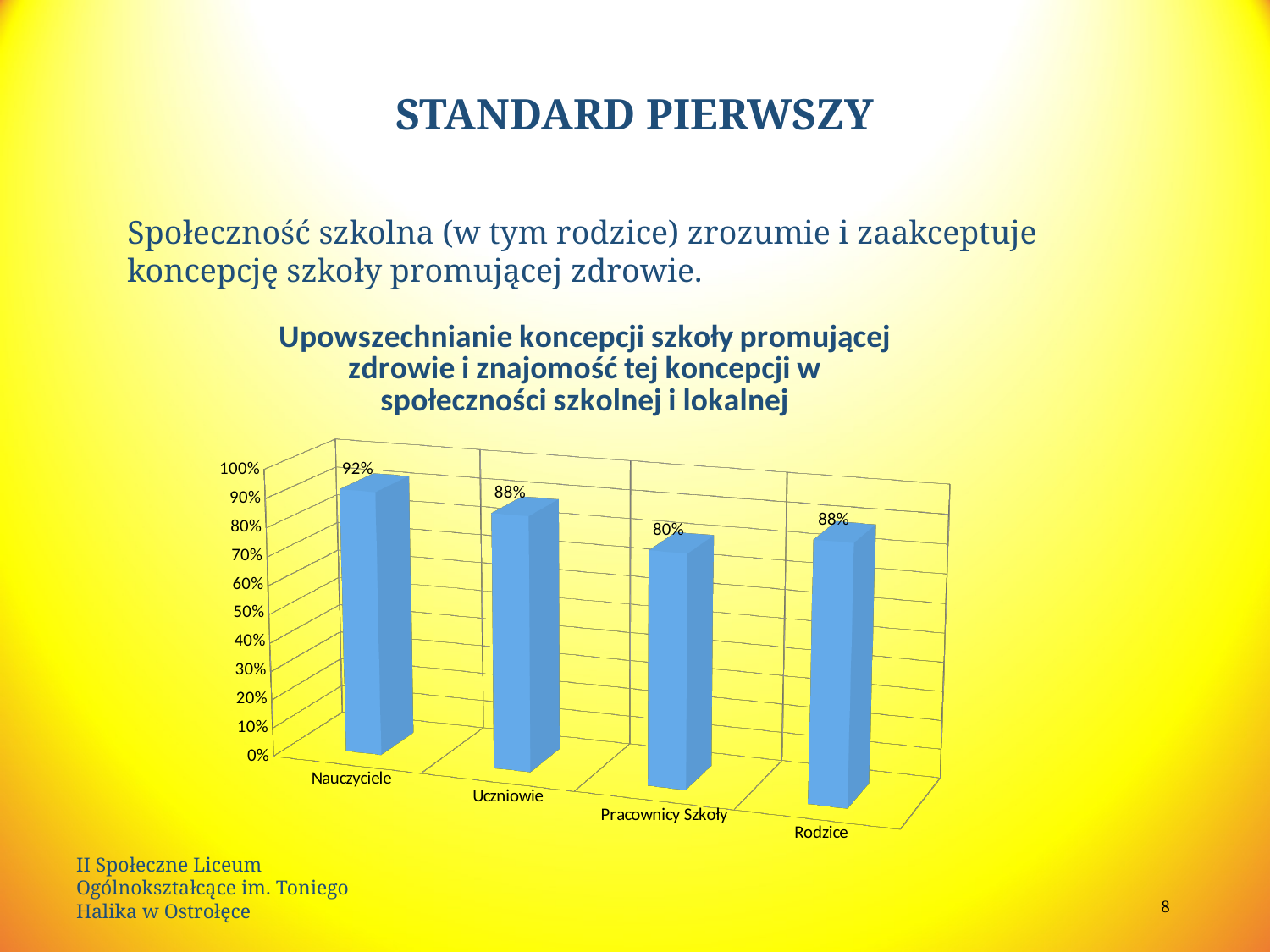
How many categories are shown on the chart? 4 What is the value for Rodzice? 88% Which category has the highest value? Nauczyciele What is the difference between the values for Uczniowie and Pracownicy Szkoły? 8% Is the value for Pracownicy Szkoły greater or less than 90%? less What is the value for Nauczyciele? 92% What is the difference between the values for Nauczyciele and Pracownicy Szkoły? 12% What is the title of the chart? Upowszechnianie koncepcji szkoły promującej zdrowie i znajomość tej koncepcji w społeczności szkolnej i lokalnej What kind of chart is shown on the slide? bar chart What is the value for Pracownicy Szkoły? 80% Which category has the lowest value? Pracownicy Szkoły Which is larger, the value for Nauczyciele or the value for Uczniowie? Nauczyciele